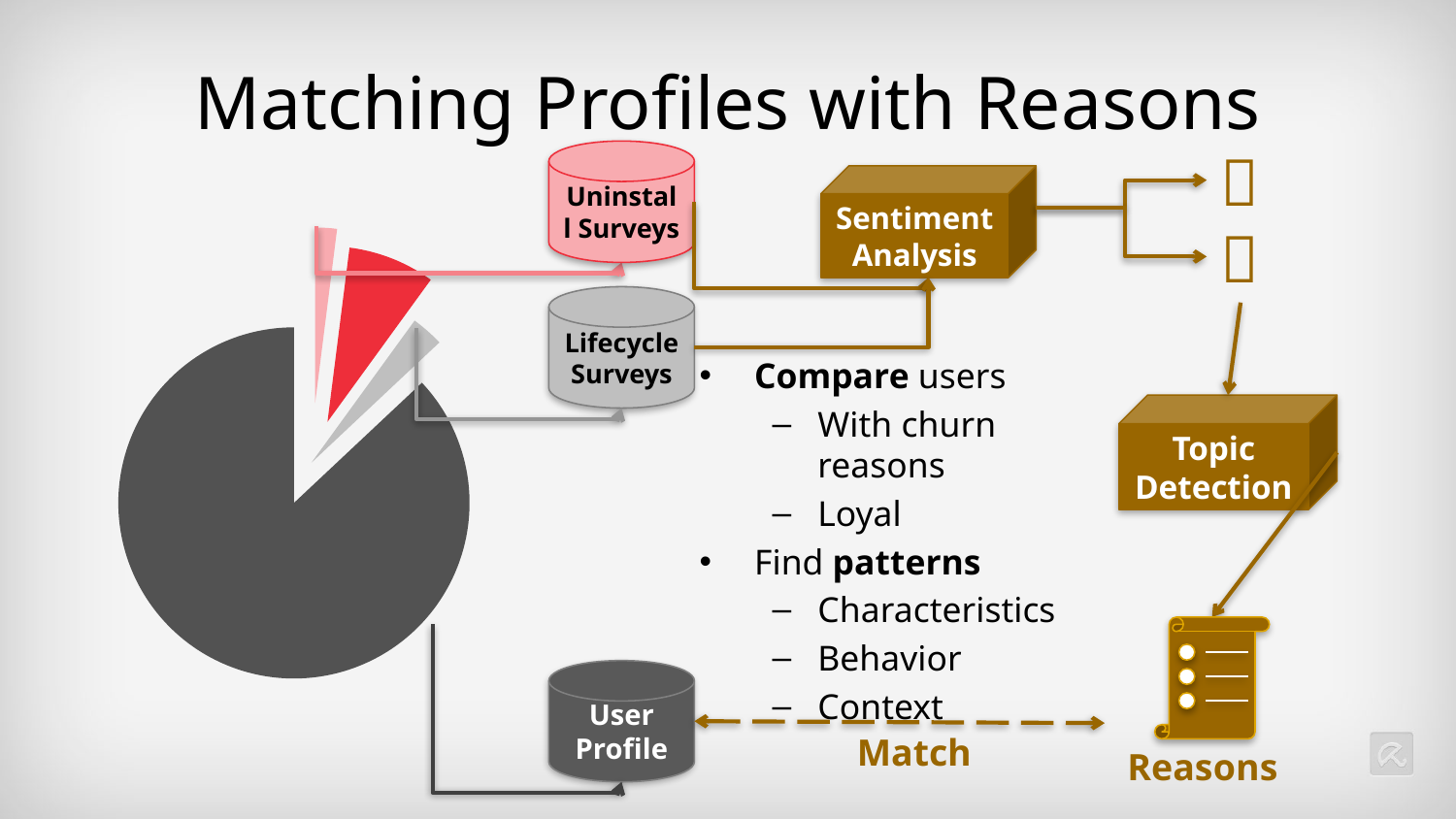
What kind of chart is shown on the left of the slide? pie chart Which colour slice of the pie chart is the largest? dark gray Does the pie chart on the slide display a legend? No Does the pie chart on the slide show any data labels or values? No